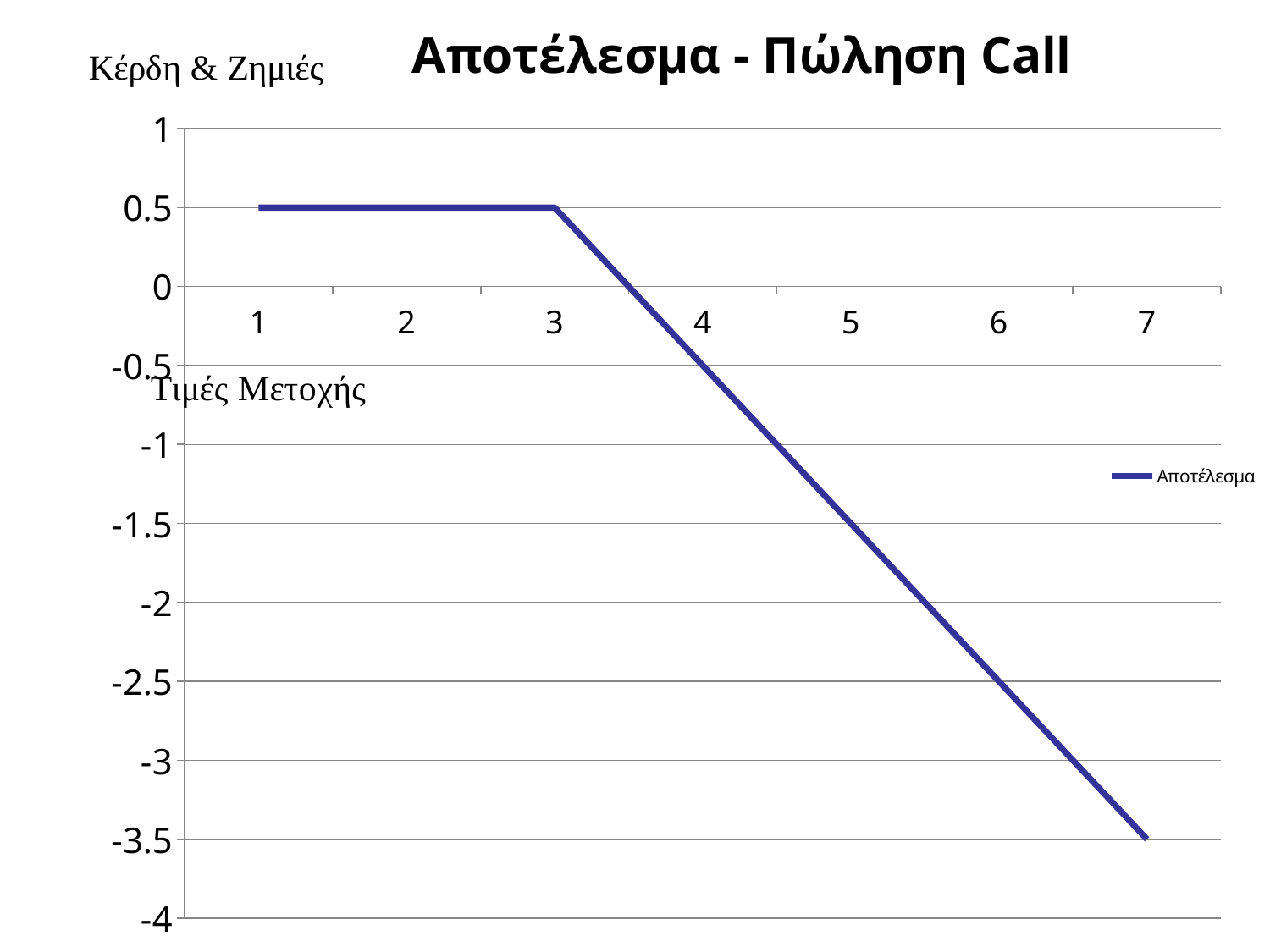
How many points are plotted along the x axis? 7 Does the value of Αποτέλεσμα rise or fall from x = 3 to x = 7? fall What is the name of the series shown in the legend? Αποτέλεσμα What is the value of Αποτέλεσμα at x = 1? 0.5 At which x value is Αποτέλεσμα lowest? 7 Which is larger, the value of Αποτέλεσμα at x = 2 or at x = 6? x = 2 What is the title of the chart? Αποτέλεσμα - Πώληση Call What is the value of Αποτέλεσμα at x = 5? -1.5 How many series does the legend list? 1 What is the value of Αποτέλεσμα at x = 7? -3.5 What is the value of Αποτέλεσμα at x = 3? 0.5 What kind of chart is shown on the slide? line chart